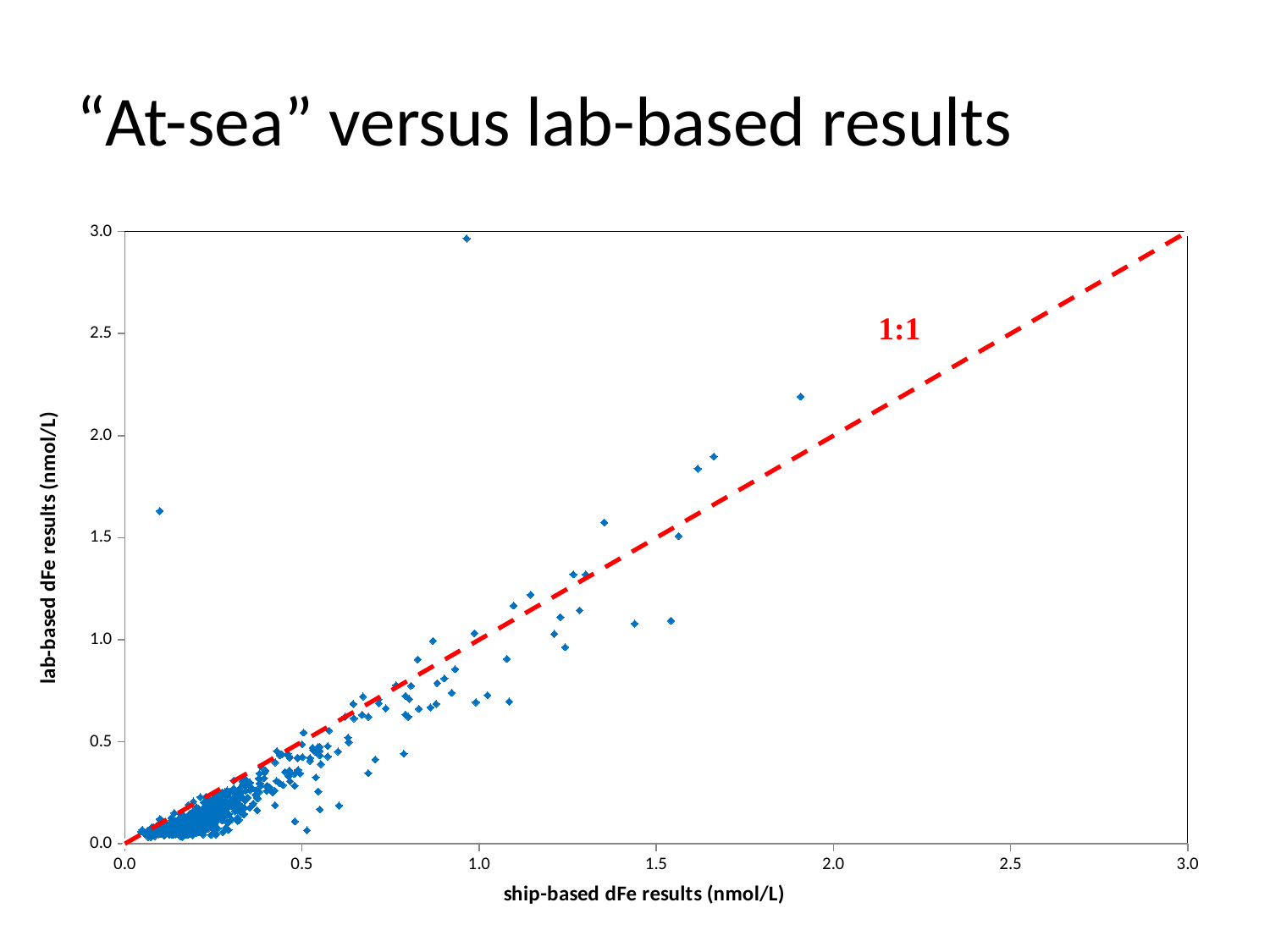
Is the lab-based dFe value of the point with the largest ship-based dFe value greater or less than 2.0? greater What label is written next to the red dashed line on the chart? 1:1 Does the point with the highest lab-based dFe value lie above or below the 1:1 line? above What is the highest value shown on the x axis of the chart? 3.0 What is the label on the x axis of the chart? ship-based dFe results (nmol/L) Overall, do the lab-based dFe values rise or fall as the ship-based dFe values increase? rise How many tick labels are shown on the y axis of the chart? 7 Is the lab-based dFe value of the outlying point near a ship-based value of 0.1 greater or less than 1.5? greater What is the highest value shown on the y axis of the chart? 3.0 Is the lab-based dFe value of the highest point on the chart greater or less than 2.5? greater What kind of chart is shown on the slide? scatter plot